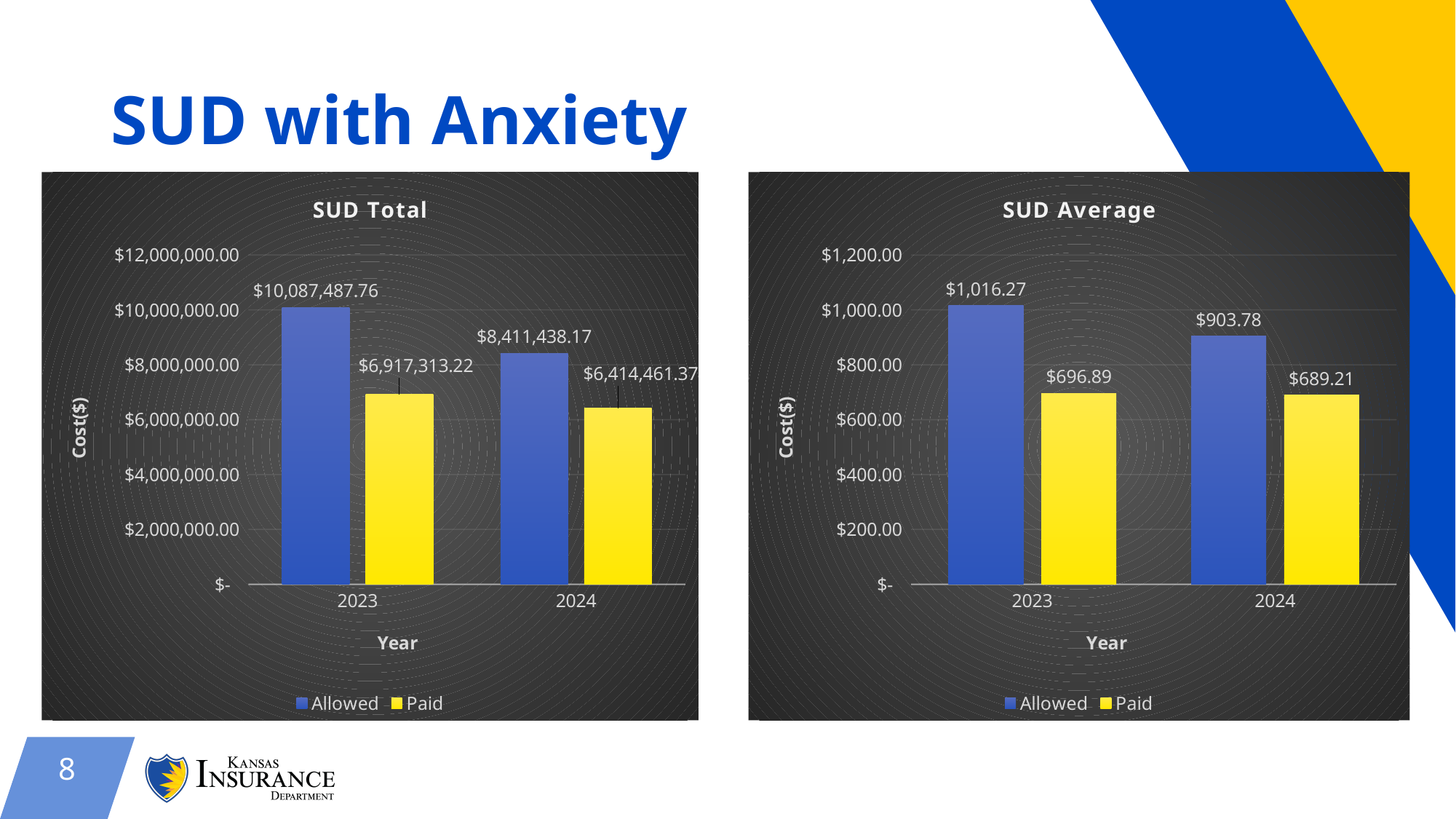
What type of chart is the SUD Average chart? bar chart In the SUD Total chart, what is the Allowed value for 2023? $10,087,487.76 In the SUD Total chart, which bar is the highest? Allowed, 2023 In the SUD Total chart, is the Allowed value for 2024 larger or smaller than the Allowed value for 2023? smaller In the SUD Average chart, does the Allowed value rise or fall from 2023 to 2024? fall In the SUD Average chart, what is the Paid value for 2023? $696.89 In the SUD Total chart, what is the difference between the Allowed and Paid values for 2023? $3,170,174.54 In the SUD Average chart, how much did the Allowed value decrease from 2023 to 2024? $112.49 In the SUD Total chart, what is the Paid value for 2024? $6,414,461.37 In the SUD Average chart, what is the Allowed value for 2024? $903.78 How many series does the legend of the SUD Total chart list? 2 In the SUD Average chart, which bar is the lowest? Paid, 2024